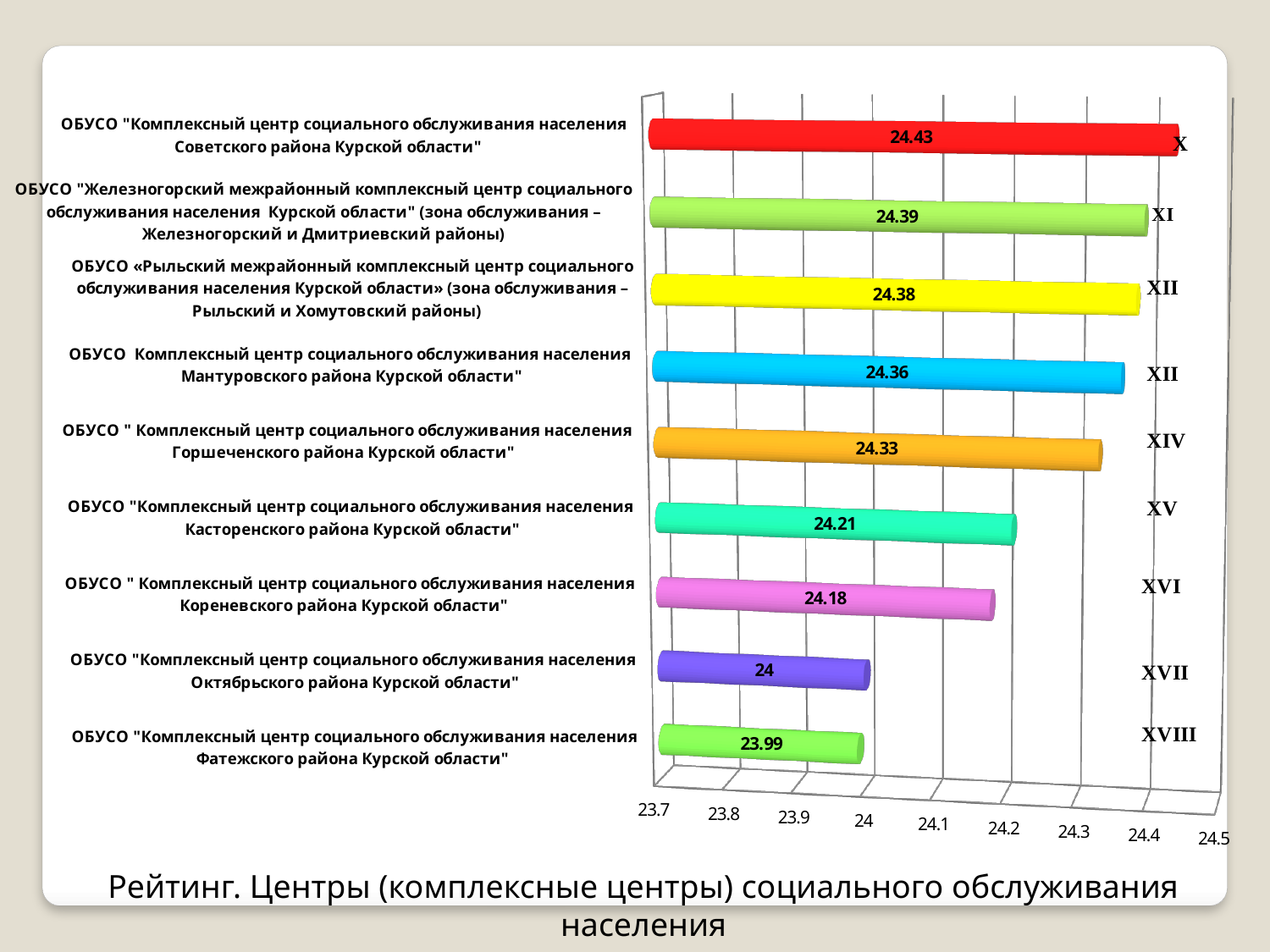
What is the value for ОБУСО "Комплексный центр социального обслуживания населения Октябрьского района Курской области"? 24 What is the value for ОБУСО "Комплексный центр социального обслуживания населения Касторенского района Курской области"? 24.21 Which has a larger value: the Горшеченского района centre or the Кореневского района centre? Горшеченского района centre Which category has the lowest value? ОБУСО "Комплексный центр социального обслуживания населения Фатежского района Курской области" What is the value for ОБУСО "Комплексный центр социального обслуживания населения Советского района Курской области"? 24.43 How many categories (bars) are shown in the chart? 9 What is the title of the chart on the slide? Рейтинг. Центры (комплексные центры) социального обслуживания населения What is the value for ОБУСО "Комплексный центр социального обслуживания населения Фатежского района Курской области"? 23.99 Which category has the highest value? ОБУСО "Комплексный центр социального обслуживания населения Советского района Курской области" What is the difference between the values for the Железногорский centre and the Рыльский centre? 0.01 What kind of chart is shown on the slide? Bar chart What is the difference between the values for the Советского района centre and the Фатежского района centre? 0.44